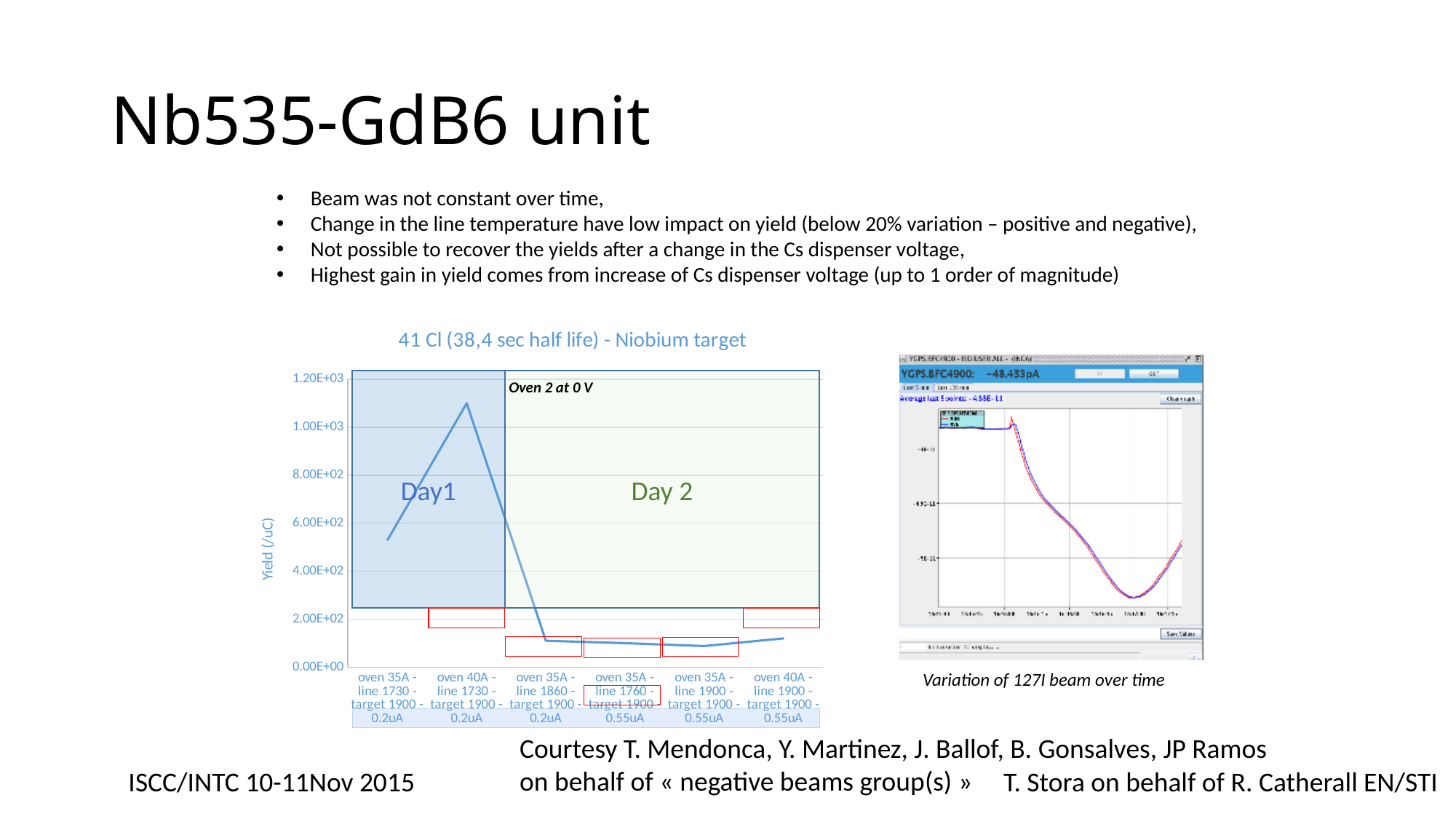
In the '41 Cl (38,4 sec half life) - Niobium target' chart, does the yield rise or fall between the second and third categories? fall In the '41 Cl (38,4 sec half life) - Niobium target' chart, is the yield for 'oven 35A - line 1860 - target 1900 - 0.2uA' greater or less than 2.00E+02? less In the '41 Cl (38,4 sec half life) - Niobium target' chart, is the yield for 'oven 35A - line 1730 - target 1900 - 0.2uA' greater or less than 4.00E+02? greater In the '41 Cl (38,4 sec half life) - Niobium target' chart, which has the larger yield: 'oven 35A - line 1730 - target 1900 - 0.2uA' or 'oven 40A - line 1730 - target 1900 - 0.2uA'? oven 40A - line 1730 - target 1900 - 0.2uA In the '41 Cl (38,4 sec half life) - Niobium target' chart, is the yield for 'oven 40A - line 1730 - target 1900 - 0.2uA' greater or less than 1.00E+03? greater How many categories are plotted along the x axis of the '41 Cl (38,4 sec half life) - Niobium target' chart? 6 What is the caption under the screenshot chart on the right of the slide? Variation of 127I beam over time What kind of chart is the '41 Cl (38,4 sec half life) - Niobium target' chart? line chart What is the y-axis label of the '41 Cl (38,4 sec half life) - Niobium target' chart? Yield (/uC) In the '41 Cl (38,4 sec half life) - Niobium target' chart, which has the larger yield: 'oven 35A - line 1730 - target 1900 - 0.2uA' or 'oven 35A - line 1900 - target 1900 - 0.55uA'? oven 35A - line 1730 - target 1900 - 0.2uA In the '41 Cl (38,4 sec half life) - Niobium target' chart, which category has the highest yield? oven 40A - line 1730 - target 1900 - 0.2uA